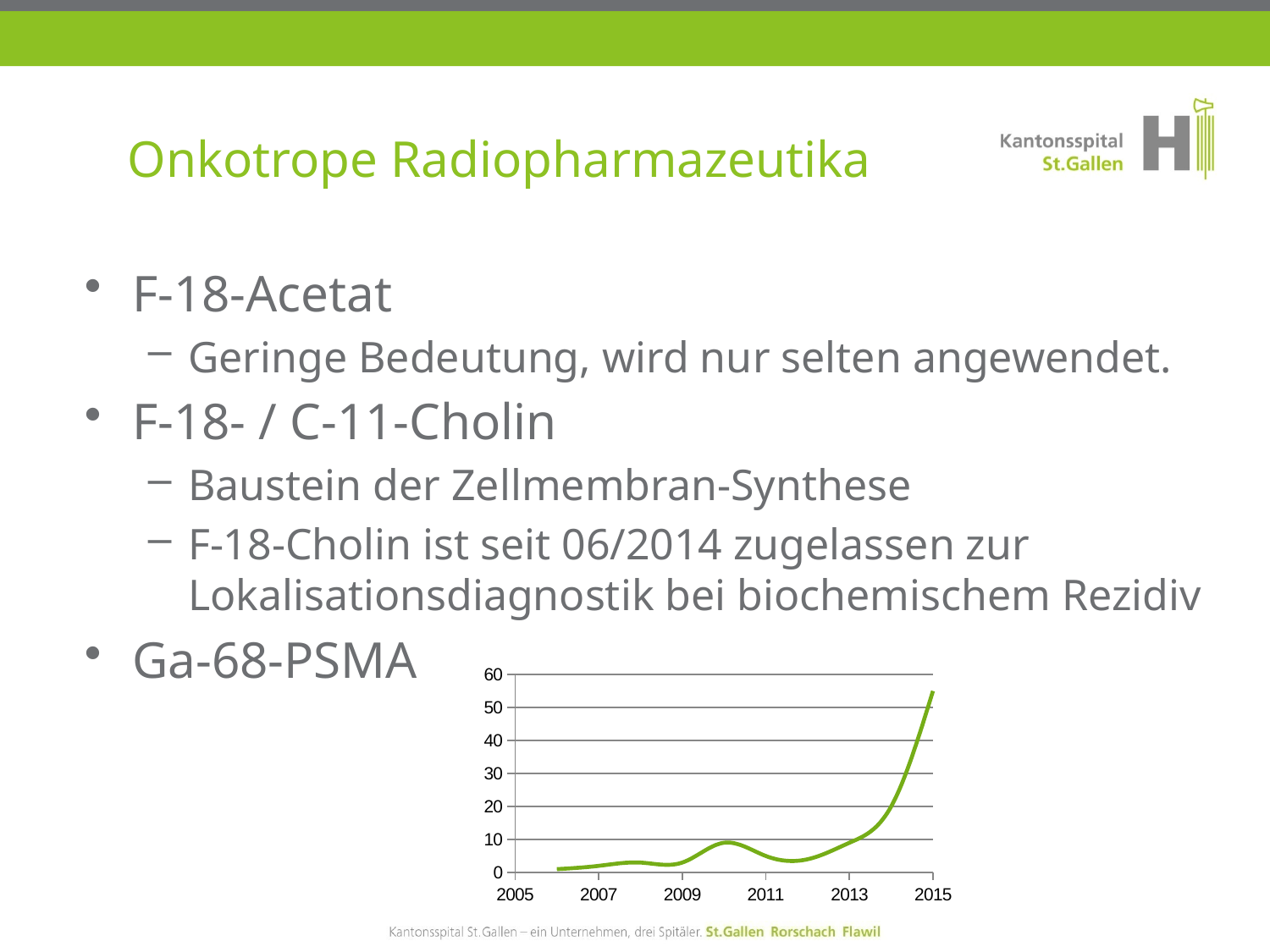
In the line chart, is the value for 2010 greater or less than 20? less In the line chart, is the value for 2015 greater or less than 50? greater What is the highest value shown on the y axis of the line chart? 60 How many year labels are shown on the x axis of the line chart? 6 In the line chart, is the value for 2012 greater or less than 10? less What kind of chart is shown at the bottom of the slide? line chart In the line chart, which is larger, the value for 2015 or the value for 2010? 2015 In the line chart, do the values overall rise or fall from 2005 to 2015? rise In the line chart, which is larger, the value for 2010 or the value for 2012? 2010 In the line chart, which year shown on the x axis has the highest value? 2015